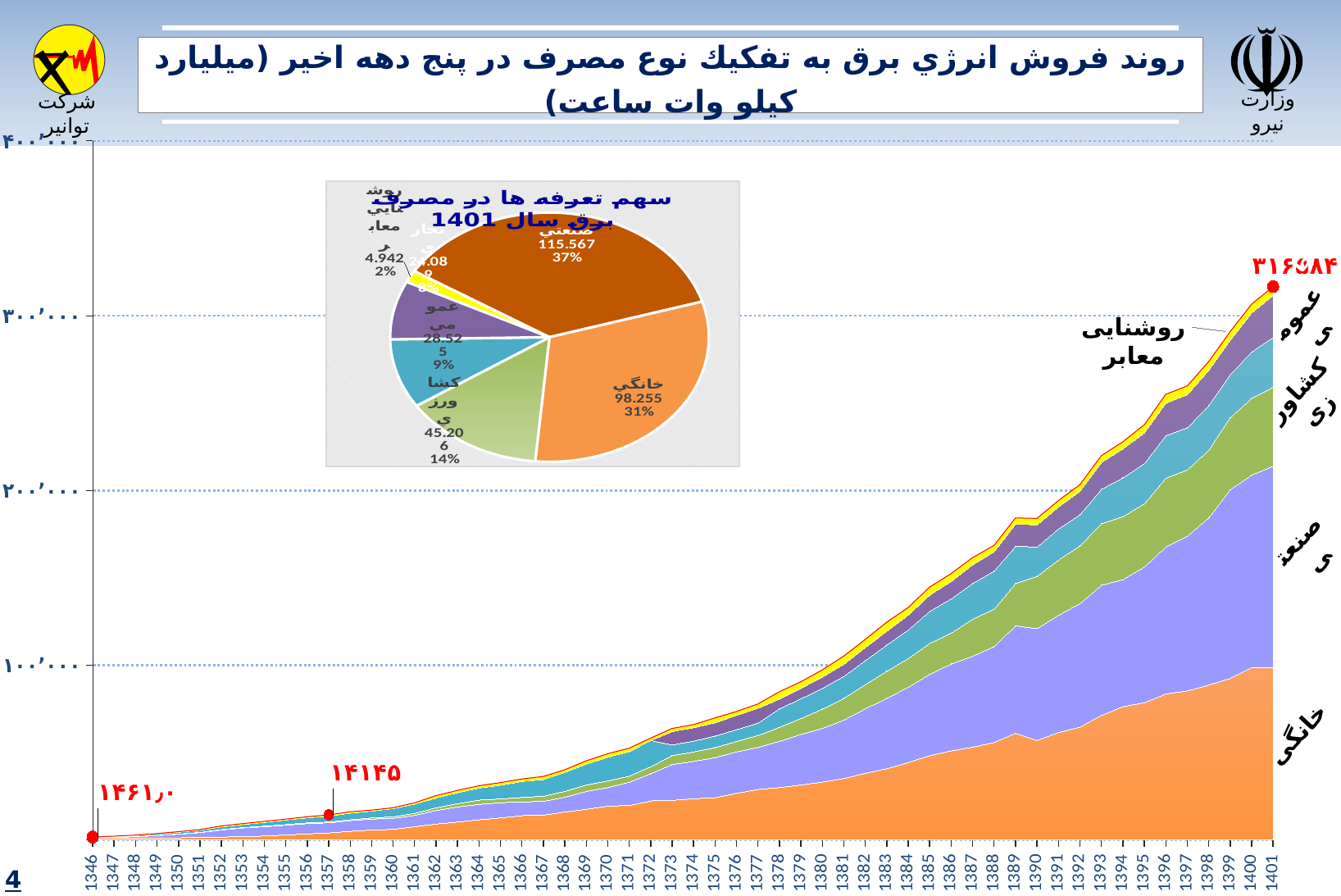
In the pie chart, what is the difference between the values for صنعتی and خانگی? 17.312 In the pie chart, what value is shown for خانگی? 98.255 In the pie chart 'سهم تعرفه ها در مصرف برق سال 1401', what percentage share does صنعتی have? 37% In the pie chart, which category has the largest slice? صنعتی In the large area chart, is the total value for 1401 greater or less than ۳۰۰٬۰۰۰? greater In the pie chart, what percentage share does کشاورزی have? 14% In the pie chart, which category has the smallest slice? روشنایی معابر How many slices does the pie chart have? 6 In the large area chart, does the total electricity sales rise or fall from 1346 to 1401? Rise In the pie chart, which is larger, صنعتی or خانگی? صنعتی In the large area chart, what value is labelled for the year 1357? ۱۴۱۴۵ What kind of chart is the large chart showing years 1346 to 1401? Stacked area chart